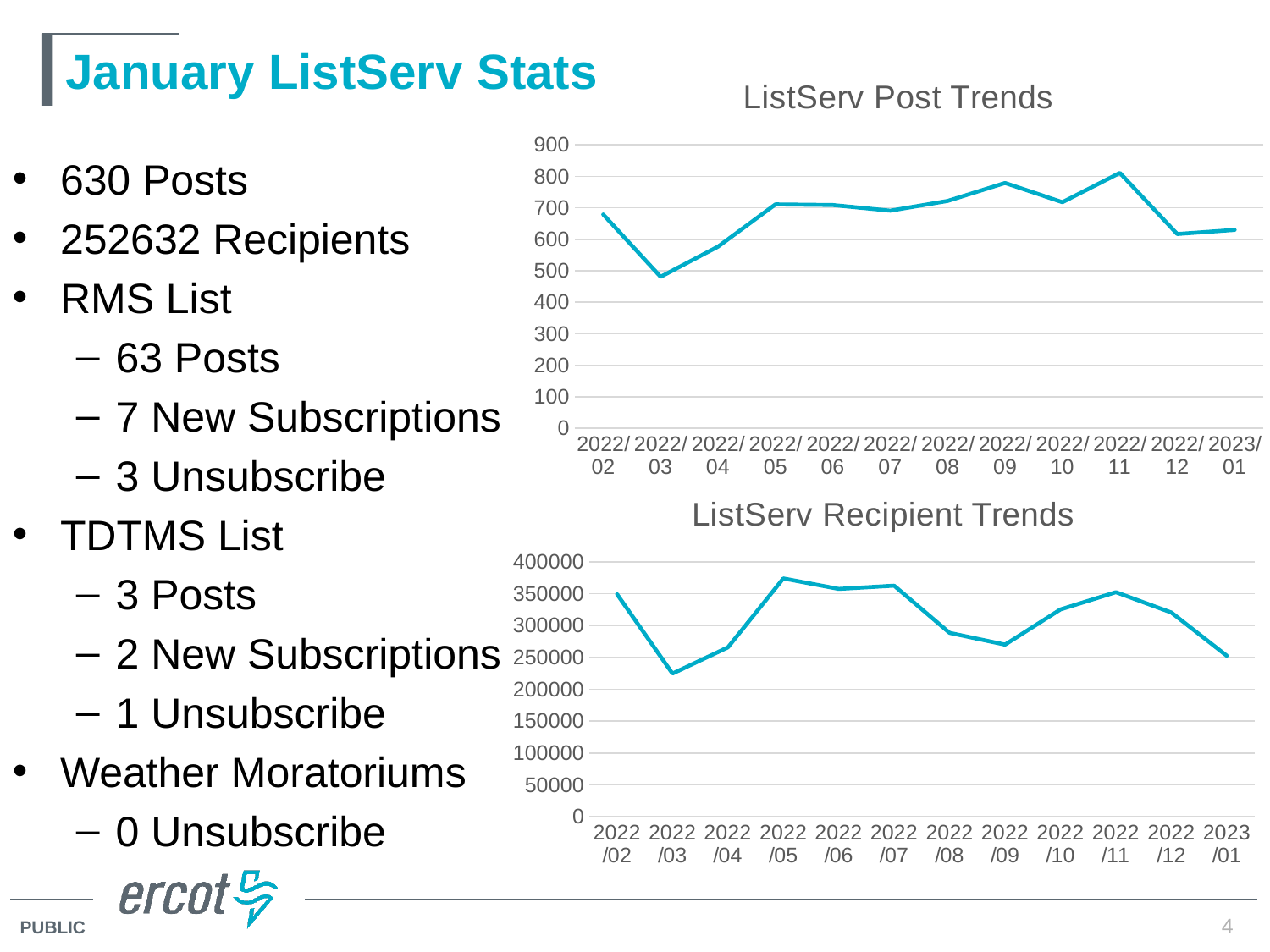
What kind of chart is the ListServ Post Trends chart? line chart In the ListServ Recipient Trends chart, which month has the lowest number of recipients? 2022/03 In the ListServ Recipient Trends chart, is the value for 2022/05 greater or less than 350000? greater What is the title of the lower chart on the slide? ListServ Recipient Trends In the ListServ Post Trends chart, is the value for 2022/03 greater or less than 500? less How many months are plotted on the ListServ Post Trends chart? 12 In the ListServ Post Trends chart, which month has the highest number of posts? 2022/11 In the ListServ Recipient Trends chart, do the values rise or fall from 2022/11 to 2023/01? fall In the ListServ Post Trends chart, which month has the lowest number of posts? 2022/03 In the ListServ Post Trends chart, which is larger, the value for 2022/11 or the value for 2022/12? 2022/11 In the ListServ Post Trends chart, do the values rise or fall from 2022/03 to 2022/05? rise